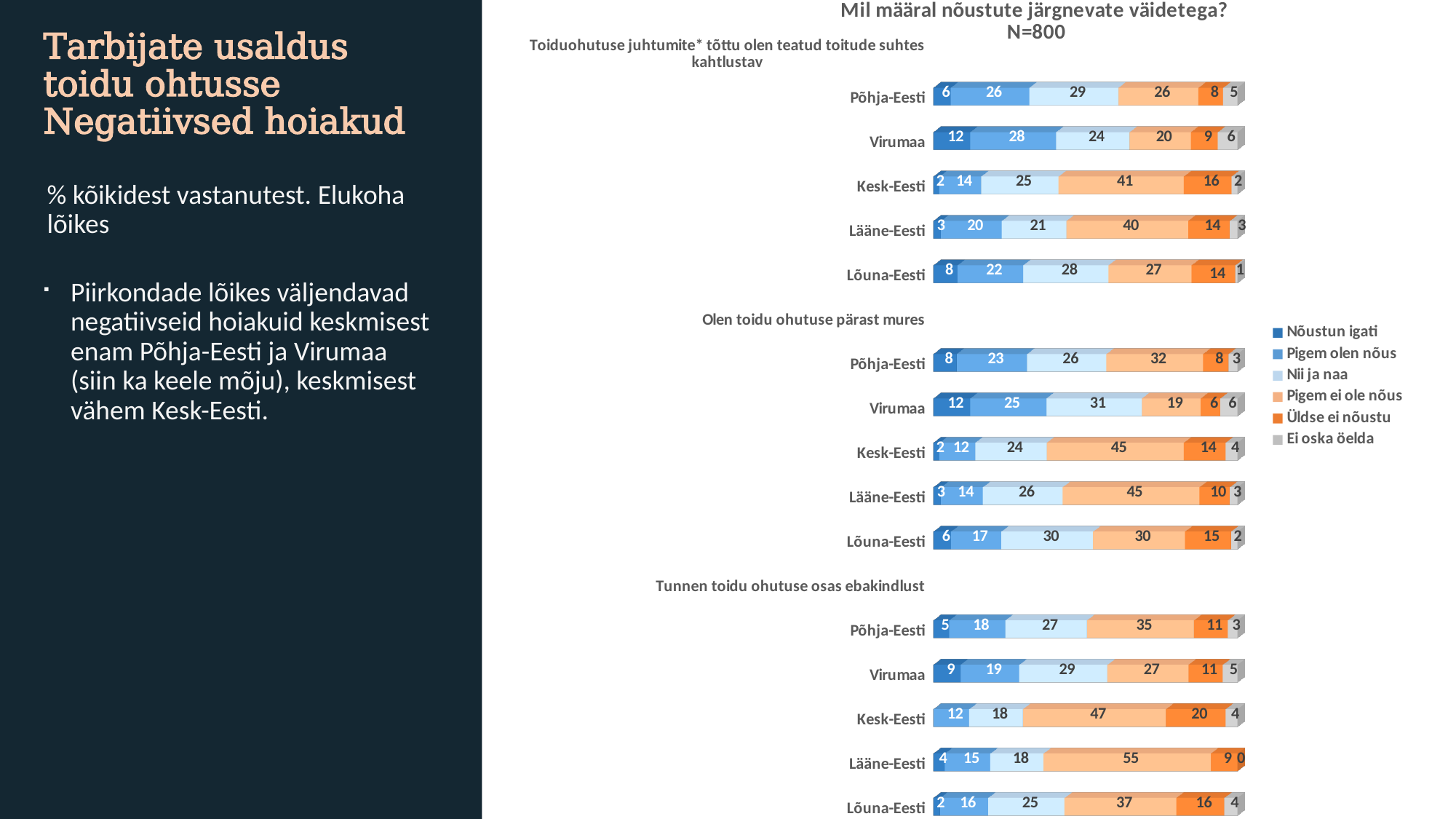
For the statement 'Tunnen toidu ohutuse osas ebakindlust', what is the difference between the 'Pigem ei ole nõus' values for Lääne-Eesti and Põhja-Eesti? 20 For the statement 'Tunnen toidu ohutuse osas ebakindlust', what is the 'Pigem ei ole nõus' value for Lääne-Eesti? 55 For the statement 'Toiduohutuse juhtumite* tõttu olen teatud toitude suhtes kahtlustav', which region has the lowest 'Pigem olen nõus' value? Kesk-Eesti For the statement 'Olen toidu ohutuse pärast mures', which region has the highest 'Nõustun igati' value? Virumaa For the statement 'Olen toidu ohutuse pärast mures', what is the 'Pigem ei ole nõus' value for Kesk-Eesti? 45 How many regions are shown for each statement? 5 For the statement 'Toiduohutuse juhtumite* tõttu olen teatud toitude suhtes kahtlustav', what is the 'Üldse ei nõustu' value for Kesk-Eesti? 16 How many series does the legend list? 6 What is the sample size (N) stated in the chart title? N=800 What type of chart is shown on the slide? stacked bar chart For the statement 'Olen toidu ohutuse pärast mures', which is larger: the 'Nii ja naa' value for Virumaa or for Lõuna-Eesti? Virumaa For the statement 'Toiduohutuse juhtumite* tõttu olen teatud toitude suhtes kahtlustav', what is the 'Nõustun igati' value for Virumaa? 12